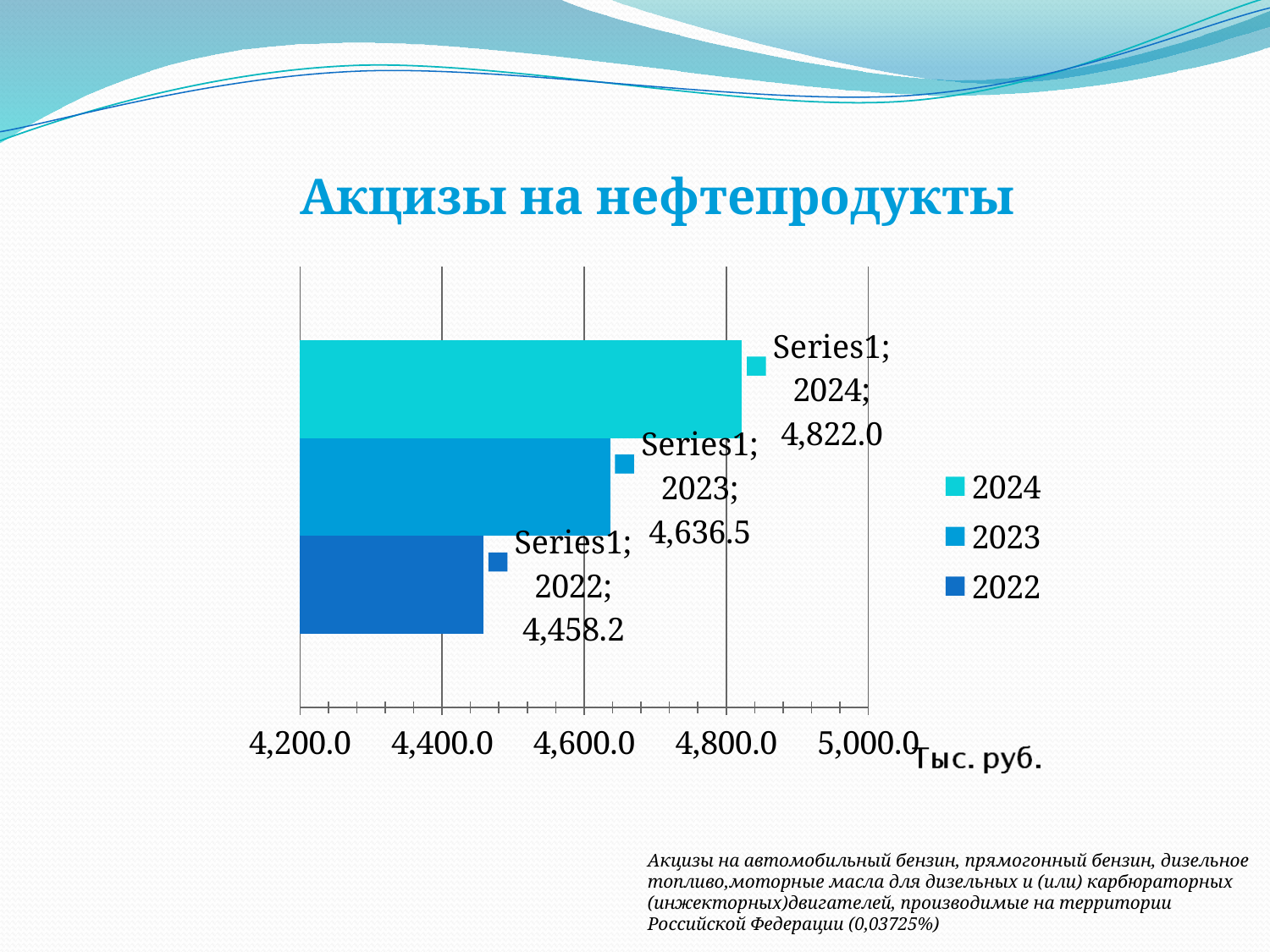
Is the value for 2024 greater or less than 4,800.0? greater What is the title of the chart? Акцизы на нефтепродукты Which year has the lowest value in the chart? 2022 Which year has the highest value in the chart? 2024 What is the value for 2024 in the chart? 4,822.0 What is the difference between the values for 2023 and 2022? 178.3 How many bars are plotted in the chart? 3 What is the value for 2022 in the chart? 4,458.2 What is the difference between the values for 2024 and 2023? 185.5 What kind of chart is shown on the slide? bar chart Which is larger, the value for 2023 or the value for 2022? 2023 What is the value for 2023 in the chart? 4,636.5